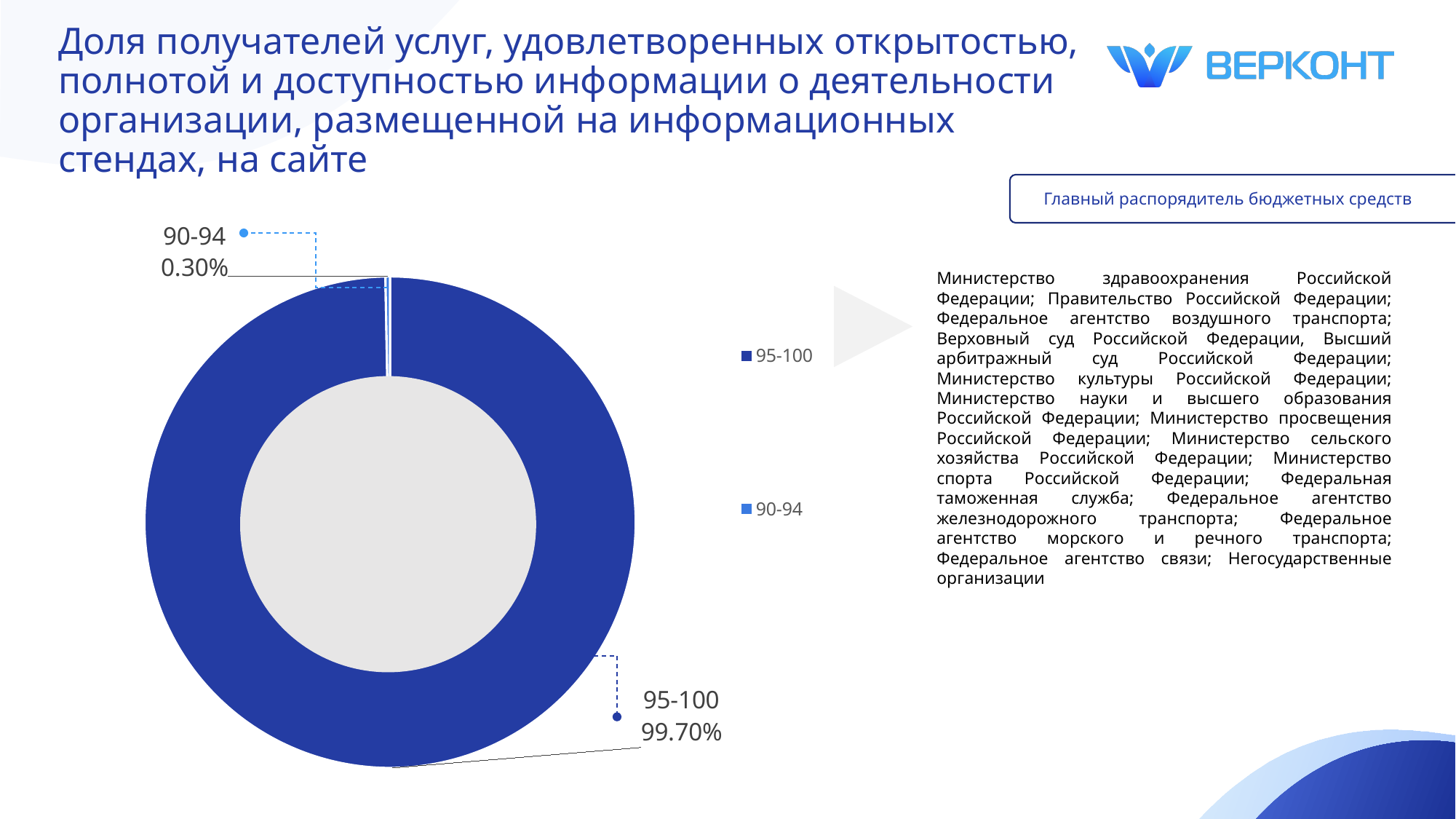
What type of chart is shown on the slide? Doughnut (pie) chart What share of the doughnut chart does the 90-94 category hold? 0.30% Which category has the largest share in the chart? 95-100 What is the total of the two shares shown in the chart? 100.00% Which is larger: the share for 95-100 or the share for 90-94? 95-100 Which legend entry is shown in dark blue? 95-100 How many categories are shown in the chart? 2 What is the difference in percentage points between the 95-100 share and the 90-94 share? 99.40% What share of the doughnut chart does the 95-100 category hold? 99.70% Which legend entry is shown in light blue? 90-94 Which category has the smallest share in the chart? 90-94 How many entries does the chart legend list? 2